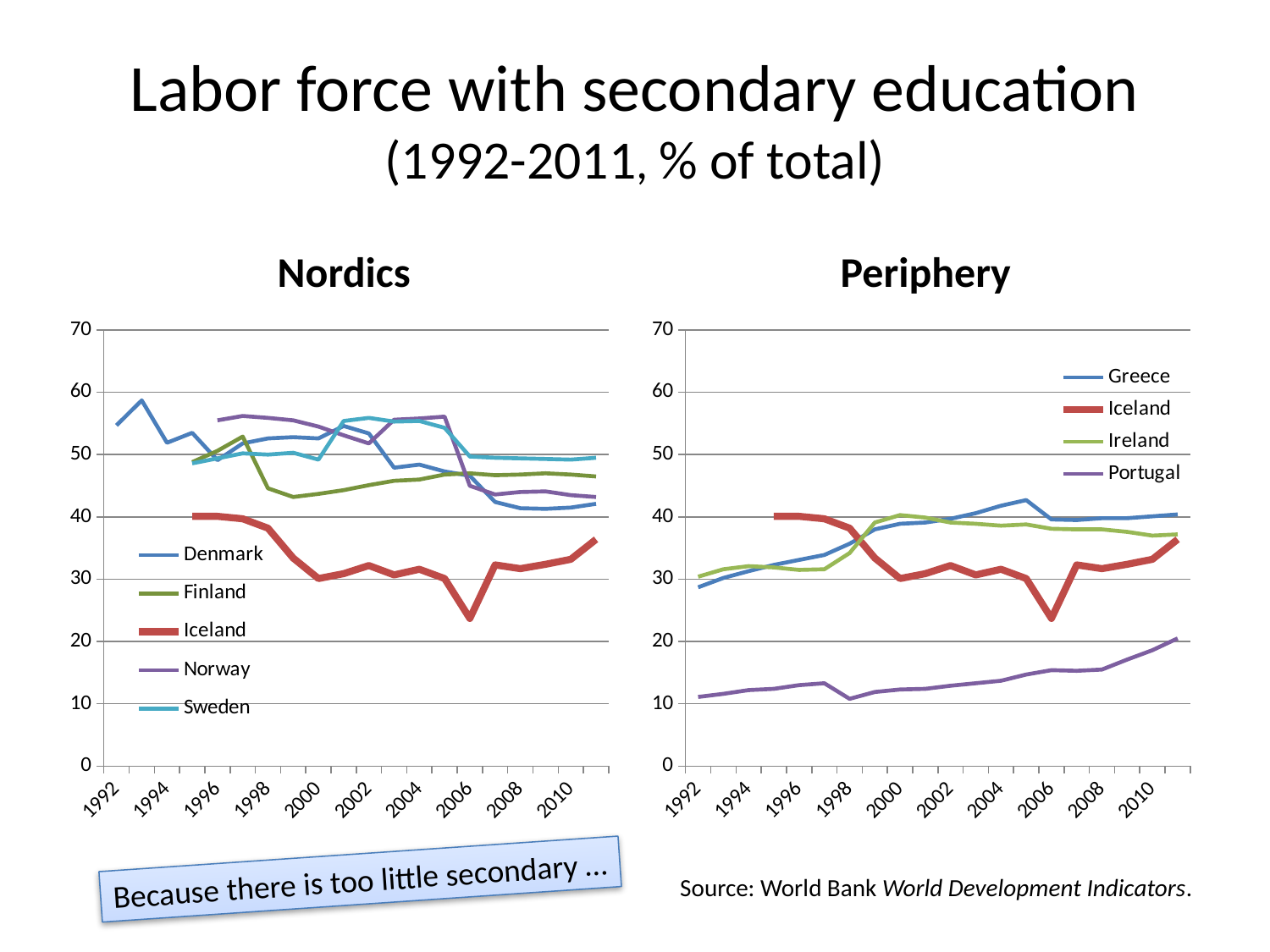
In the Nordics chart, is the value for Denmark in 1993 greater or less than 50? greater In the Nordics chart, does the value for Denmark rise or fall from 1992 to 2011? fall How many series does the legend of the Nordics chart list? 5 What kind of chart is the Nordics chart? line chart In the Periphery chart, is the value for Portugal in 1992 greater or less than 20? less In the Nordics chart, which is larger in 2011, Finland or Iceland? Finland In the Periphery chart, which country has the lowest value in 2011? Portugal In the Nordics chart, is the value for Finland in 2011 greater or less than 40? greater In the Periphery chart, does the value for Portugal rise or fall from 1992 to 2011? rise What is the title of the right-hand chart? Periphery How many series does the legend of the Periphery chart list? 4